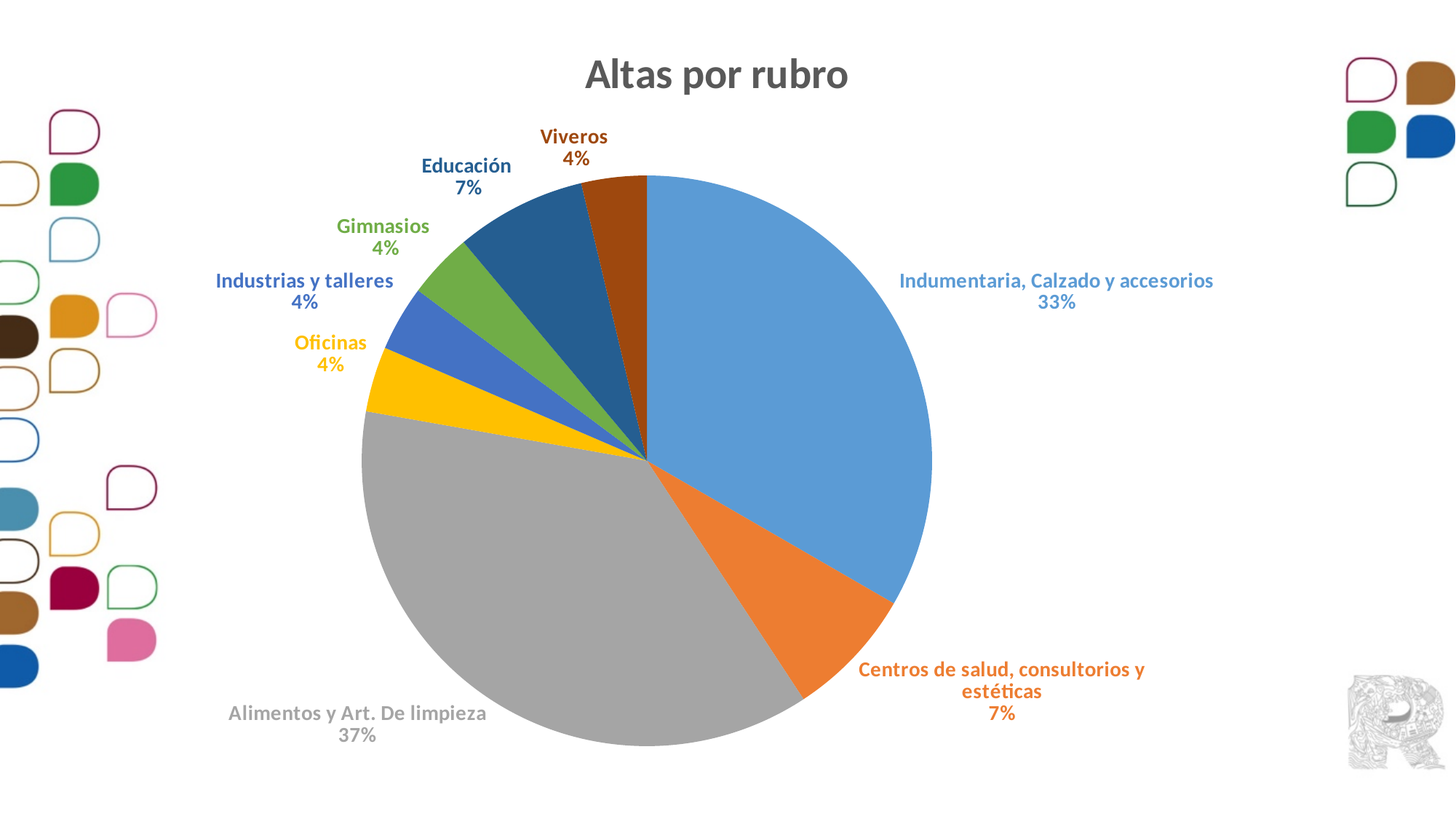
What is the value for Indumentaria, Calzado y accesorios? 33% What is the difference between the shares of Alimentos y Art. De limpieza and Indumentaria, Calzado y accesorios? 4% What is the value for Centros de salud, consultorios y estéticas? 7% What is the title of the chart? Altas por rubro What is the value for Educación? 7% What colour is the slice for Oficinas? yellow What is the value for Viveros? 4% Which category has the largest share of the pie? Alimentos y Art. De limpieza Which is larger, the share for Educación or the share for Gimnasios? Educación What type of chart is shown on the slide? pie chart What share of the pie does Alimentos y Art. De limpieza represent? 37% How many categories are shown in the pie chart? 8